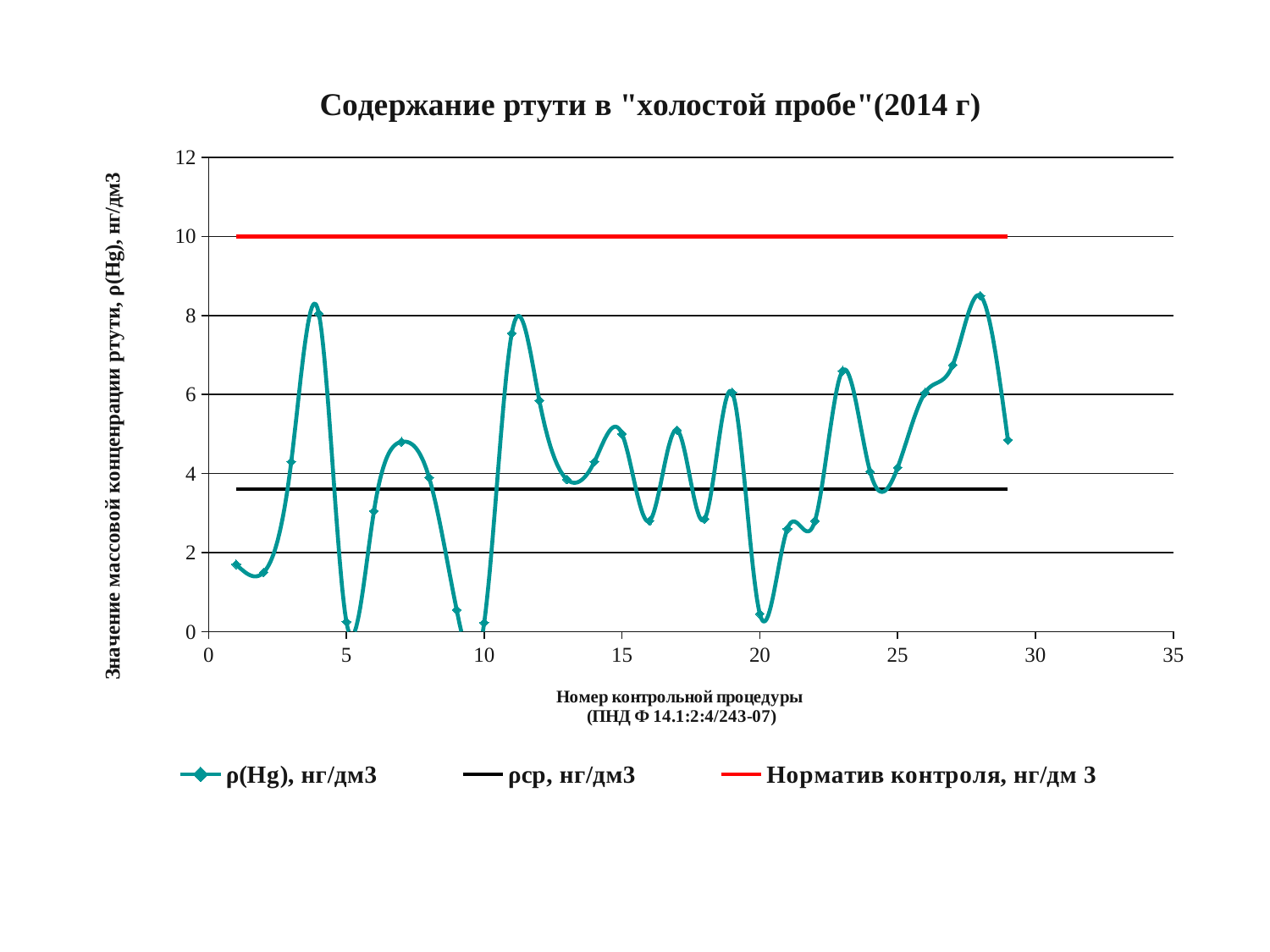
Which has the larger ρ(Hg) value, control procedure 3 or control procedure 20? control procedure 3 What kind of chart is shown on the slide? line chart Is the ρ(Hg) value for control procedure 11 greater or less than 6? greater Is the ρ(Hg) value for control procedure 20 greater or less than 2? less What is the title of the chart? Содержание ртути в "холостой пробе"(2014 г) Is the ρ(Hg) value for control procedure 9 greater or less than 2? less What is the value of the Норматив контроля line? 10 How many series does the legend list? 3 Does the ρ(Hg) series ever exceed the Норматив контроля line? No Which has the larger ρ(Hg) value, control procedure 11 or control procedure 13? control procedure 11 Which legend entry corresponds to the red line? Норматив контроля, нг/дм 3